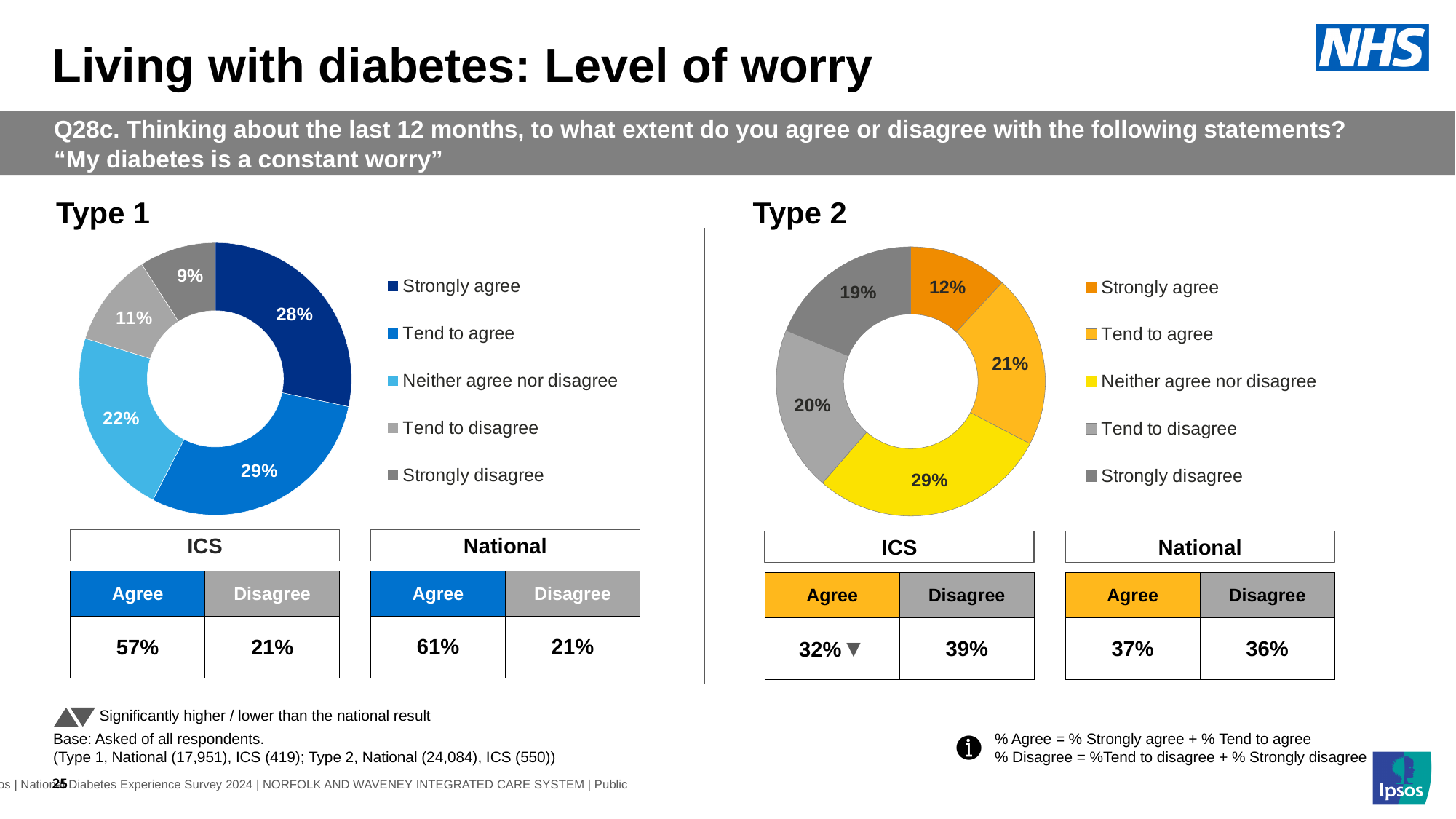
In the Type 1 chart, which response category has the smallest share? Strongly disagree How many response categories does the legend of the Type 2 chart list? 5 In the Type 1 chart, what is the difference between the 'Tend to agree' and 'Tend to disagree' shares? 18 percentage points What kind of chart is used to show the Type 1 results? Pie (doughnut) chart In the Type 1 chart, what percentage of respondents said 'Strongly agree'? 28% In the Type 2 chart, what percentage of respondents said 'Strongly disagree'? 19% In the Type 1 chart, what percentage of respondents said 'Neither agree nor disagree'? 22% In the Type 2 chart, what percentage of respondents said 'Tend to agree'? 21% In the Type 2 chart, which is larger: 'Strongly agree' or 'Strongly disagree'? Strongly disagree In the Type 1 chart, which response category has the largest share? Tend to agree In the Type 2 chart, which response category has the smallest share? Strongly agree In the Type 2 chart, which response category has the largest share? Neither agree nor disagree